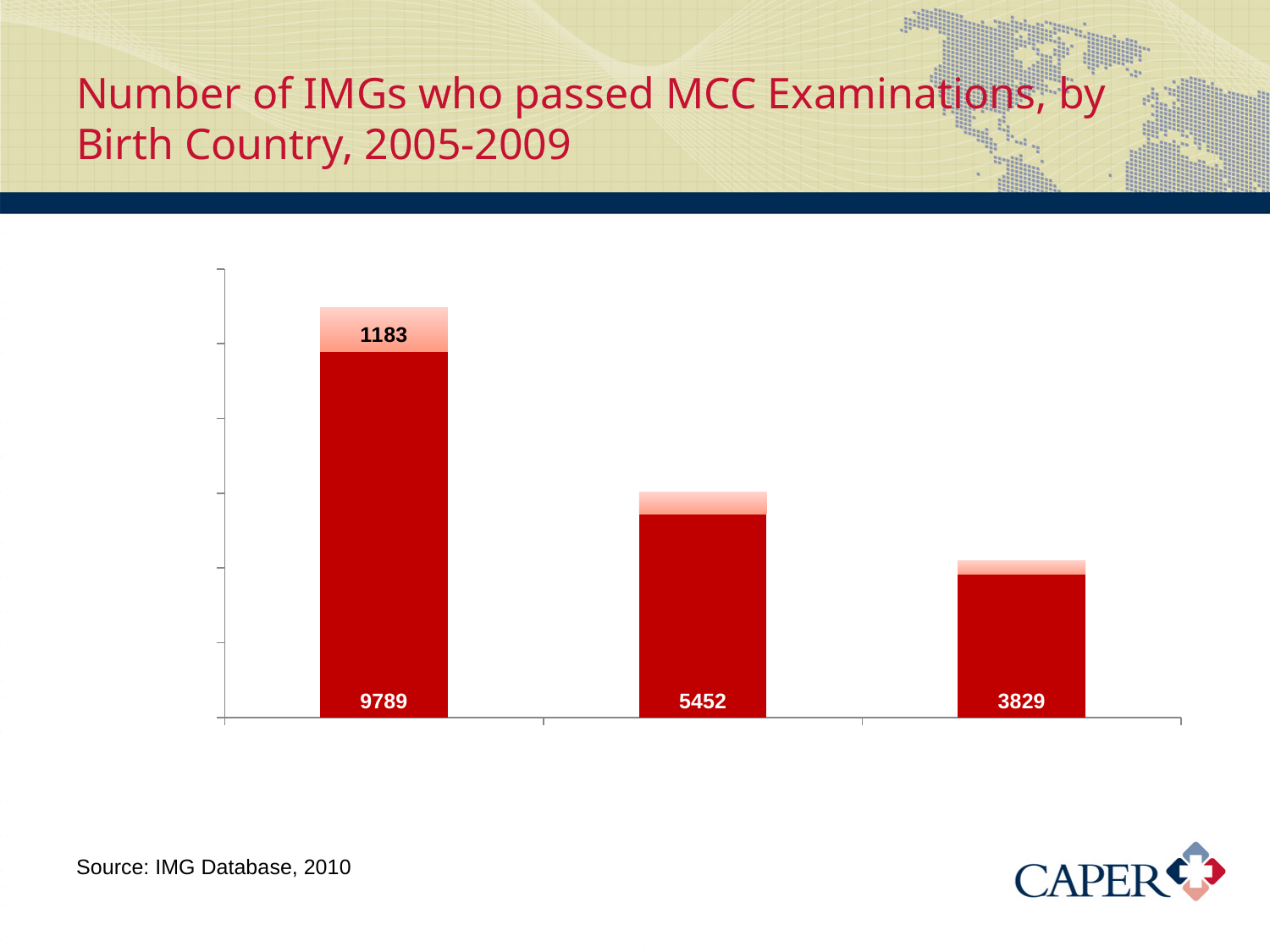
Which bar is the shortest: the left, middle, or right one? right What value is printed on the dark red segment of the middle bar? 5452 What is the total of the two labelled segments of the leftmost bar (9789 and 1183)? 10972 What value is printed on the dark red segment of the leftmost bar? 9789 Which bar is the tallest: the left, middle, or right one? left What is the difference between the dark red values of the leftmost bar (9789) and the middle bar (5452)? 4337 What is the difference between the dark red values of the middle bar (5452) and the rightmost bar (3829)? 1623 What value is printed on the light pink top segment of the leftmost bar? 1183 What value is printed on the dark red segment of the rightmost bar? 3829 What is the title of the slide containing the chart? Number of IMGs who passed MCC Examinations, by Birth Country, 2005-2009 How many bars are plotted in the chart? 3 What kind of chart is shown on the slide? bar chart